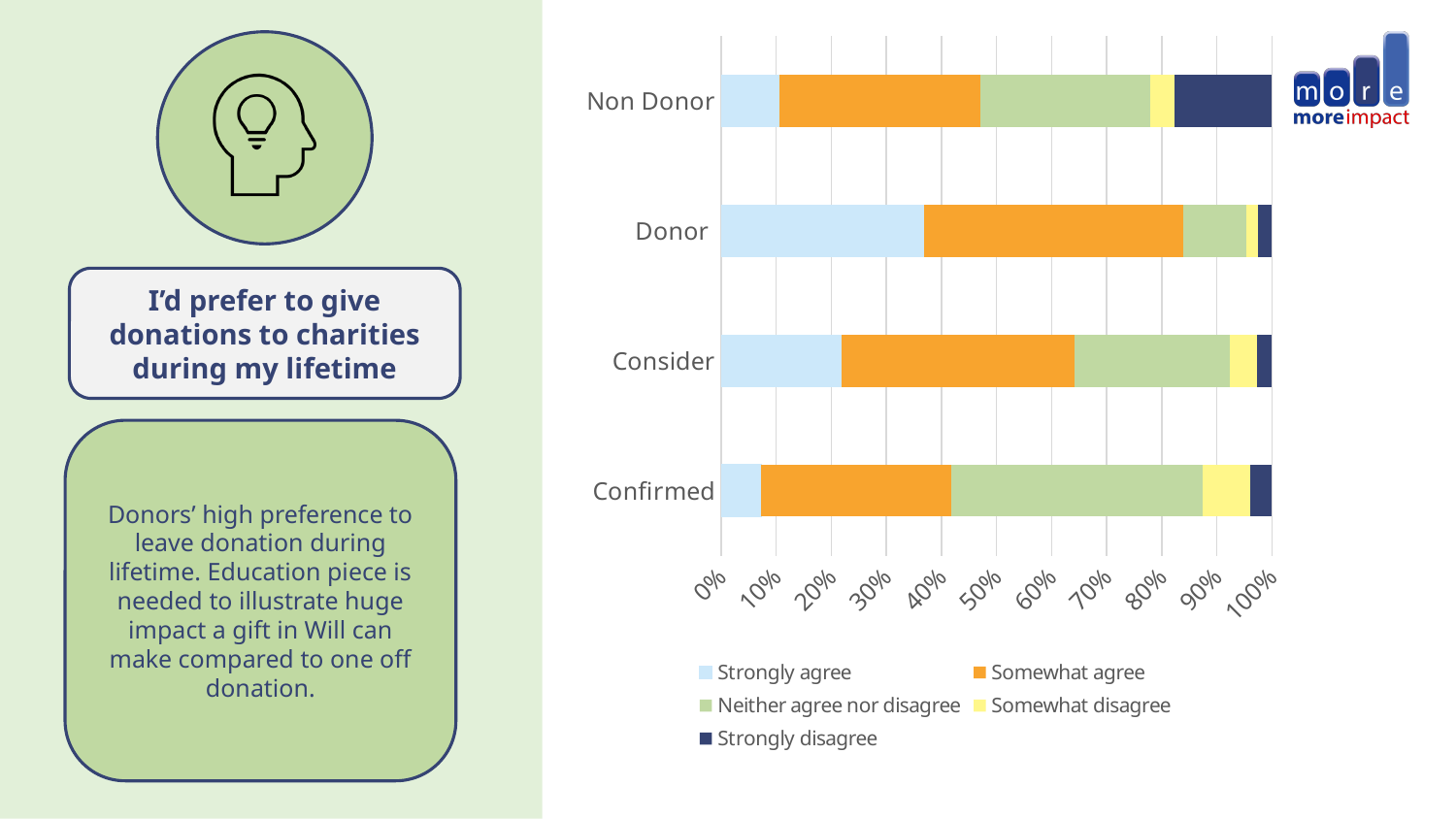
Which is larger, the Neither agree nor disagree segment for Confirmed or for Donor? Confirmed Is the Strongly agree value for Donor greater or less than 30%? greater Which is larger, the Strongly agree segment for Donor or for Non Donor? Donor How many series does the chart legend list? 5 Which category has the largest Strongly disagree segment? Non Donor Which category has the largest Neither agree nor disagree segment? Confirmed Is the Strongly agree value for Confirmed greater or less than 10%? less Which category has the largest Strongly agree segment? Donor What colour represents Somewhat agree in the legend? Orange Is the Strongly disagree value for Non Donor greater or less than 10%? greater What kind of chart is shown on the slide? Stacked bar chart How many categories are plotted on the chart? 4